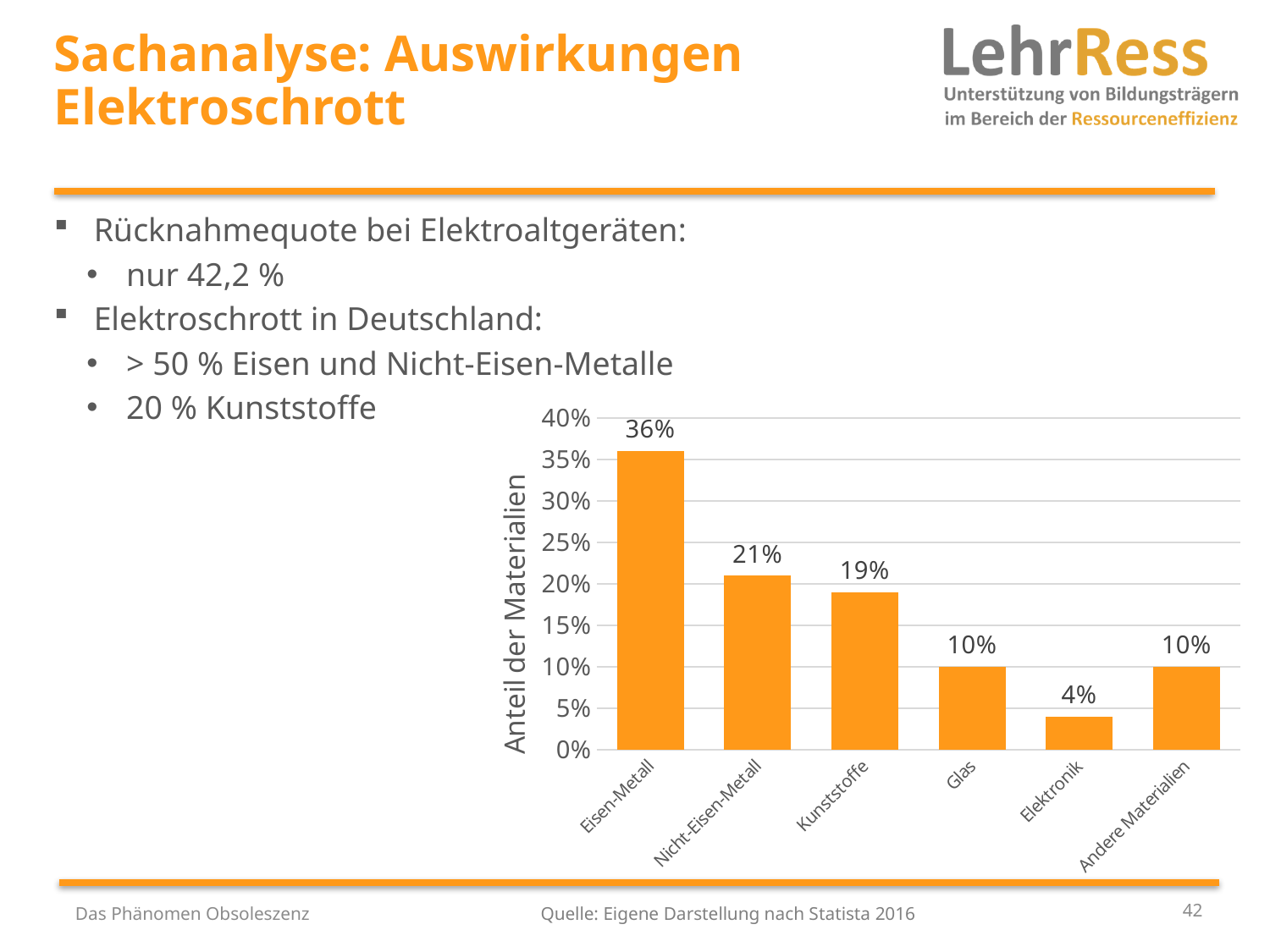
How many categories are shown on the x axis? 6 What is the value for Nicht-Eisen-Metall? 21% Which category has the lowest value? Elektronik What is the value for Elektronik? 4% What is the value for Eisen-Metall? 36% What kind of chart is shown on the slide? Bar chart Which category has the highest value? Eisen-Metall What is the difference between the values for Glas and Elektronik? 6% Which is larger, the value for Kunststoffe or the value for Glas? Kunststoffe What is the value for Kunststoffe? 19% What is the difference between the values for Eisen-Metall and Nicht-Eisen-Metall? 15% What is the label of the vertical axis? Anteil der Materialien